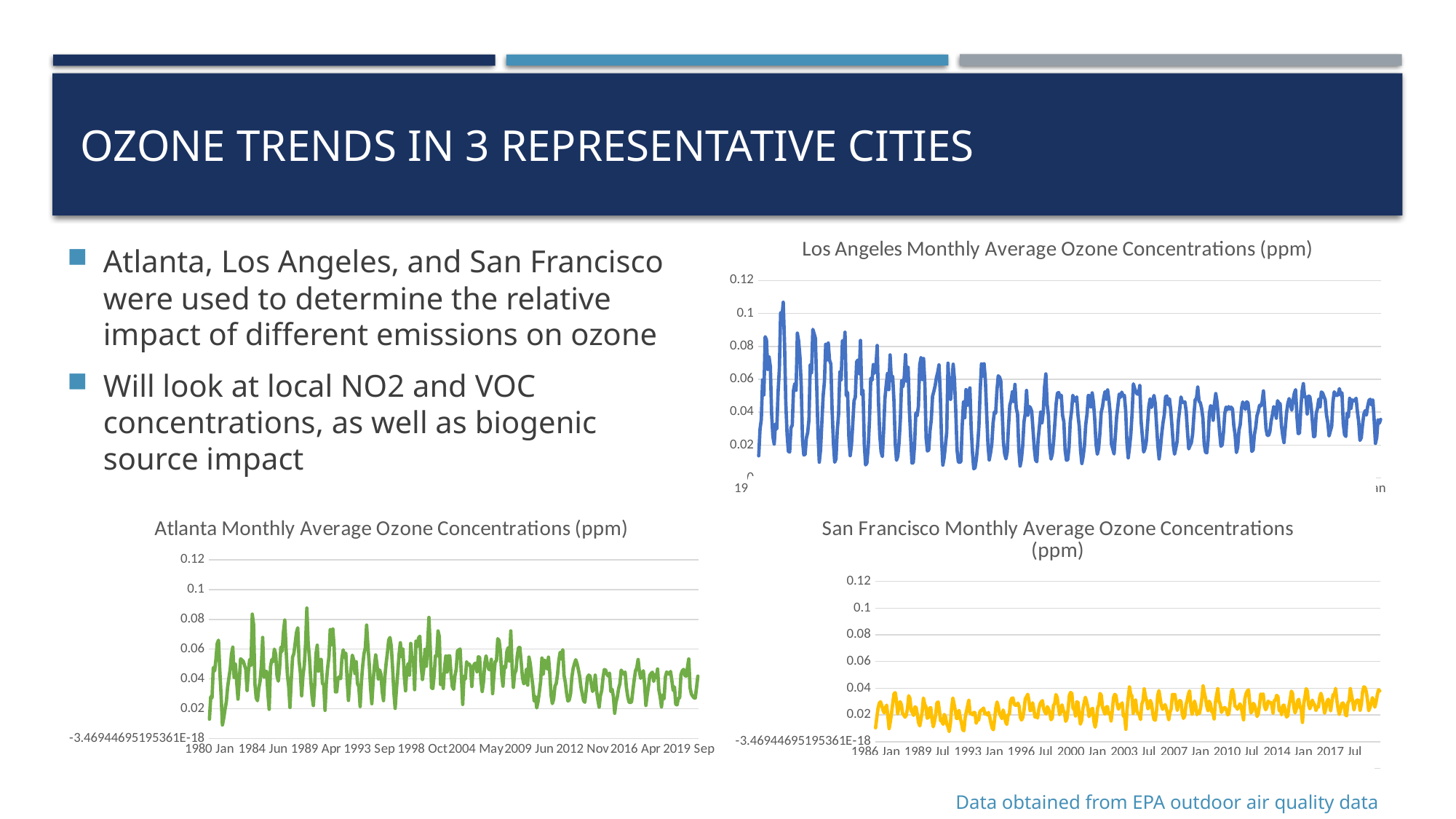
How many charts are shown on the slide? 3 On the Atlanta Monthly Average Ozone Concentrations chart, is the highest value greater or less than 0.1? less What kind of chart is the Los Angeles Monthly Average Ozone Concentrations chart? line chart What is the highest value shown on the y axis of the San Francisco Monthly Average Ozone Concentrations chart? 0.12 On the Los Angeles Monthly Average Ozone Concentrations chart, do the values generally rise or fall over time? fall On the Los Angeles Monthly Average Ozone Concentrations chart, is the highest value greater or less than 0.08? greater What is the first x-axis label on the Atlanta Monthly Average Ozone Concentrations chart? 1980 Jan What colour is the line on the Atlanta Monthly Average Ozone Concentrations chart? green On the San Francisco Monthly Average Ozone Concentrations chart, is the highest value greater or less than 0.06? less Comparing the three charts, which city has the lowest peak monthly average ozone concentration? San Francisco On the Atlanta Monthly Average Ozone Concentrations chart, do the peak values generally rise or fall over time? fall Comparing the three charts, which city reaches the highest monthly average ozone concentration? Los Angeles